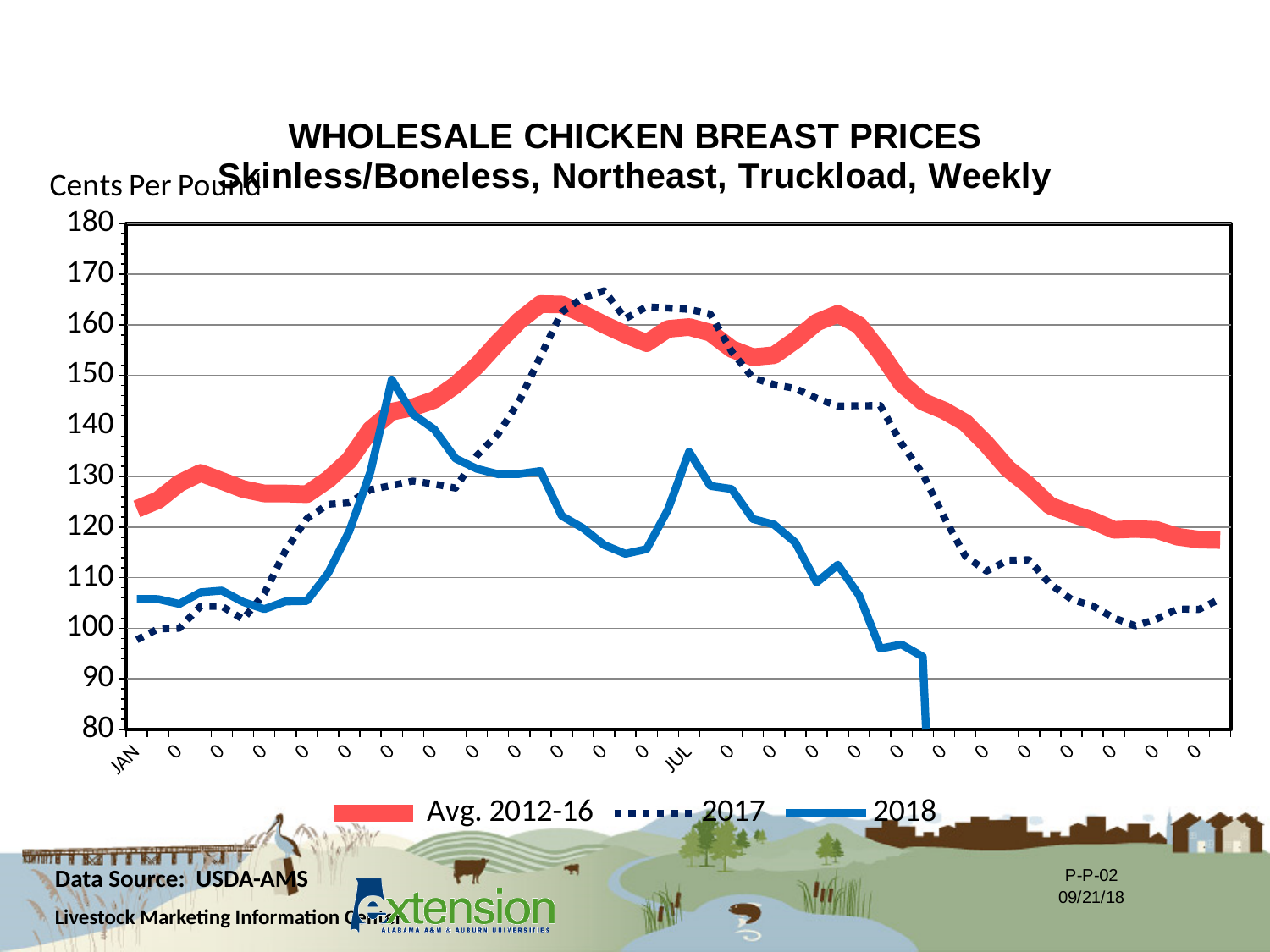
Is the Avg. 2012-16 value at the last point on the right greater or less than 120? less What kind of chart is shown on the slide? line chart What is the title of the chart? WHOLESALE CHICKEN BREAST PRICES Skinless/Boneless, Northeast, Truckload, Weekly Is the 2018 value at JAN greater or less than 100? greater Is the Avg. 2012-16 value at JAN greater or less than 120? greater How many series does the legend list? 3 From JUL to the right end of the chart, does the Avg. 2012-16 line generally rise or fall? fall At JUL, which series is higher, Avg. 2012-16 or 2018? Avg. 2012-16 What unit is shown on the vertical axis of the chart? Cents Per Pound At JAN, which series is higher, 2017 or 2018? 2018